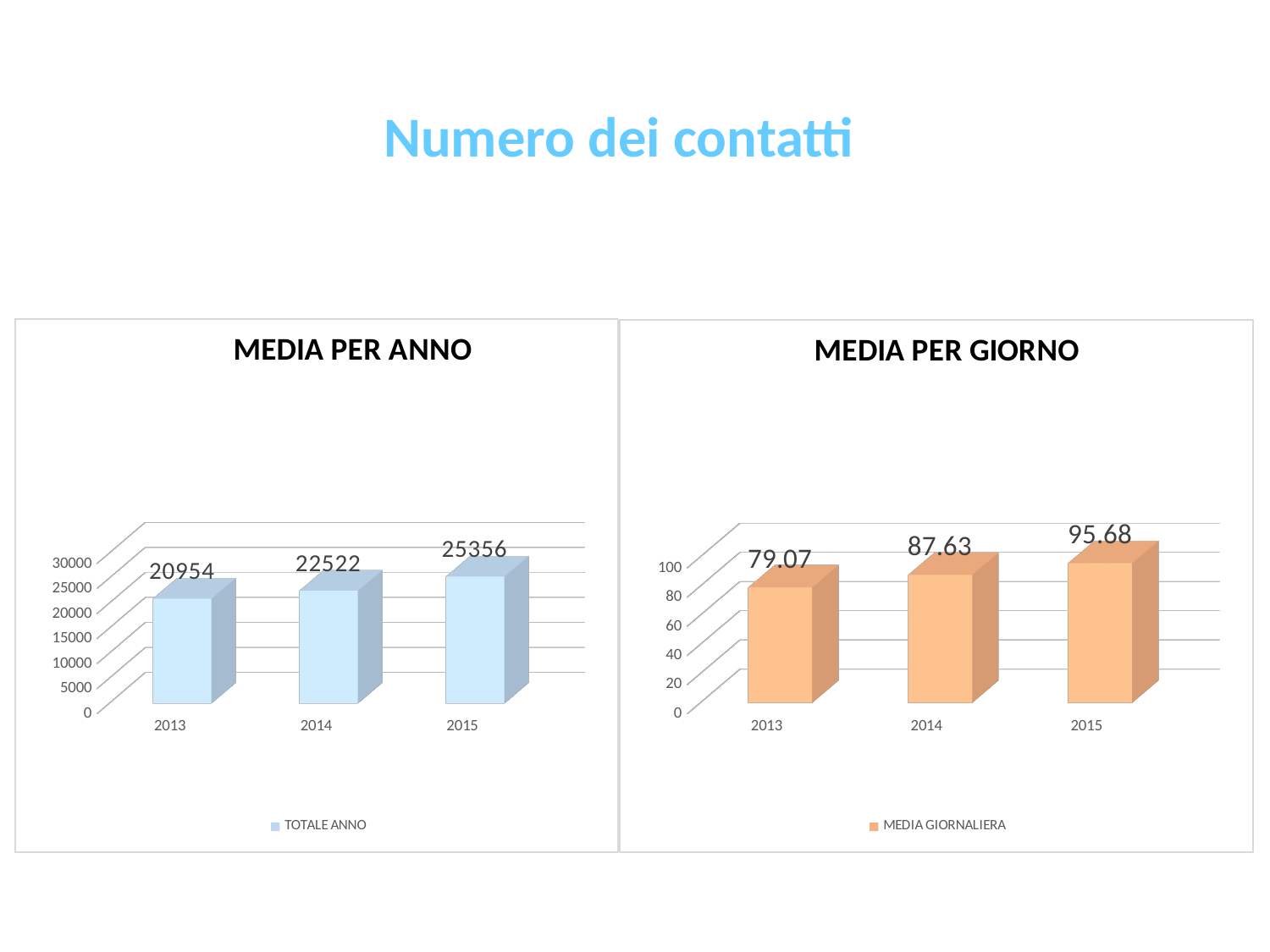
In the 'MEDIA PER ANNO' chart, which year has the highest value? 2015 In the 'MEDIA PER GIORNO' chart, which year has the lowest value? 2013 In the 'MEDIA PER GIORNO' chart, what is the value for 2013? 79.07 What is the legend entry in the 'MEDIA PER ANNO' chart? TOTALE ANNO In the 'MEDIA PER ANNO' chart, what is the value for 2014? 22522 In the 'MEDIA PER GIORNO' chart, what is the difference between the values for 2015 and 2014? 8.05 In the 'MEDIA PER ANNO' chart, what is the difference between the values for 2015 and 2013? 4402 How many years are shown in the 'MEDIA PER ANNO' chart? 3 What kind of chart is the 'MEDIA PER GIORNO' chart? bar chart In the 'MEDIA PER GIORNO' chart, is the value for 2015 greater or less than 80? greater In the 'MEDIA PER GIORNO' chart, do the values rise or fall from 2013 to 2015? rise In the 'MEDIA PER ANNO' chart, which is larger, the value for 2013 or the value for 2014? 2014